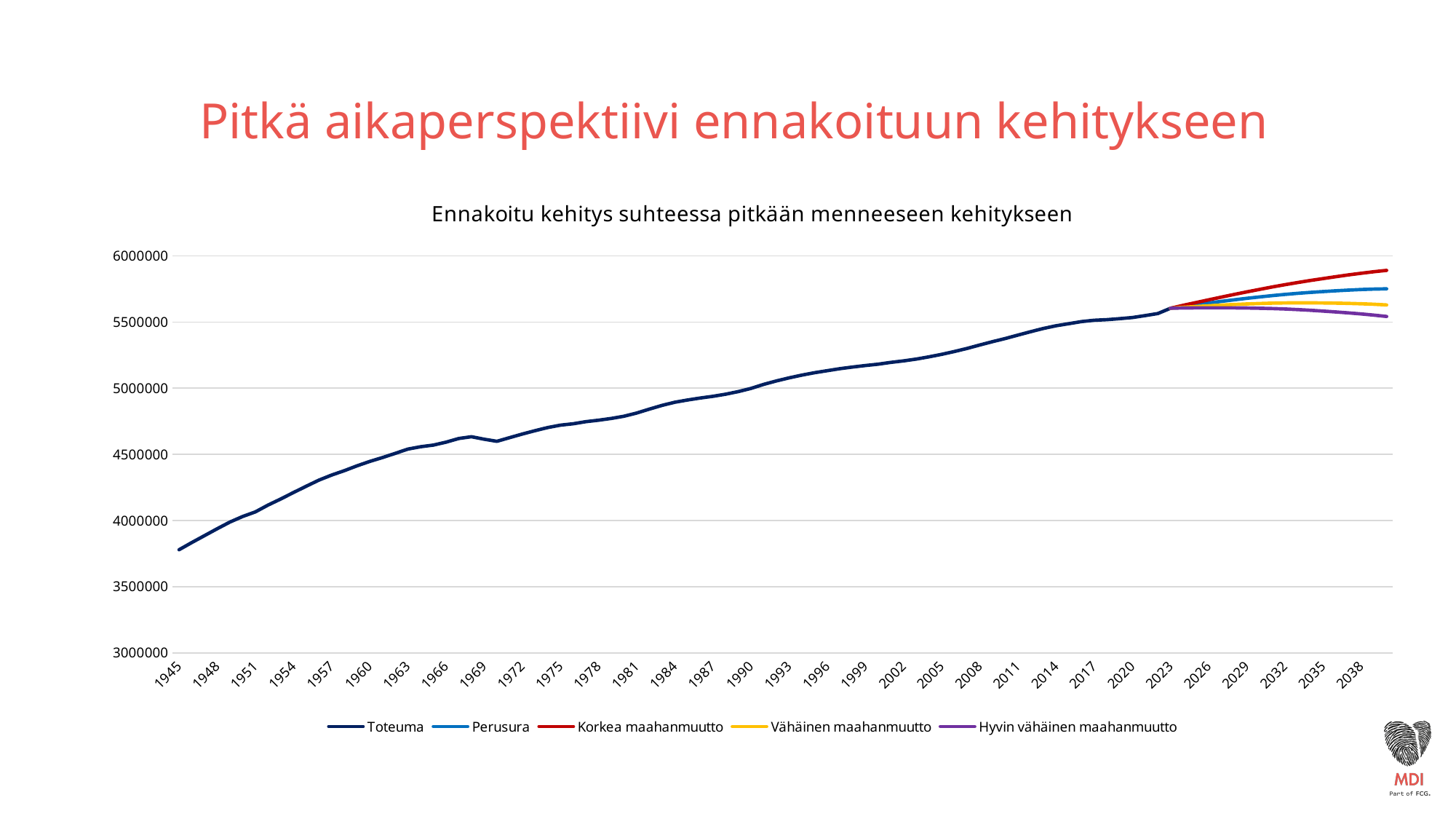
What is the title of the chart? Ennakoitu kehitys suhteessa pitkään menneeseen kehitykseen Is the value for Korkea maahanmuutto at the right end of the chart greater or less than 6000000? less How many series does the legend list? 5 Is the value for Toteuma in 1957 greater or less than 4500000? less Is the value for Toteuma in 1945 greater or less than 4000000? less What kind of chart is shown on the slide? line chart Which projection series is lowest at the right end of the chart (2038 and beyond)? Hyvin vähäinen maahanmuutto Does the Toteuma series generally rise or fall from 1945 to 2023? rise Which projection series is highest at the right end of the chart (2038 and beyond)? Korkea maahanmuutto Which series is drawn in red? Korkea maahanmuutto At the right end of the chart, which is higher: Perusura or Vähäinen maahanmuutto? Perusura